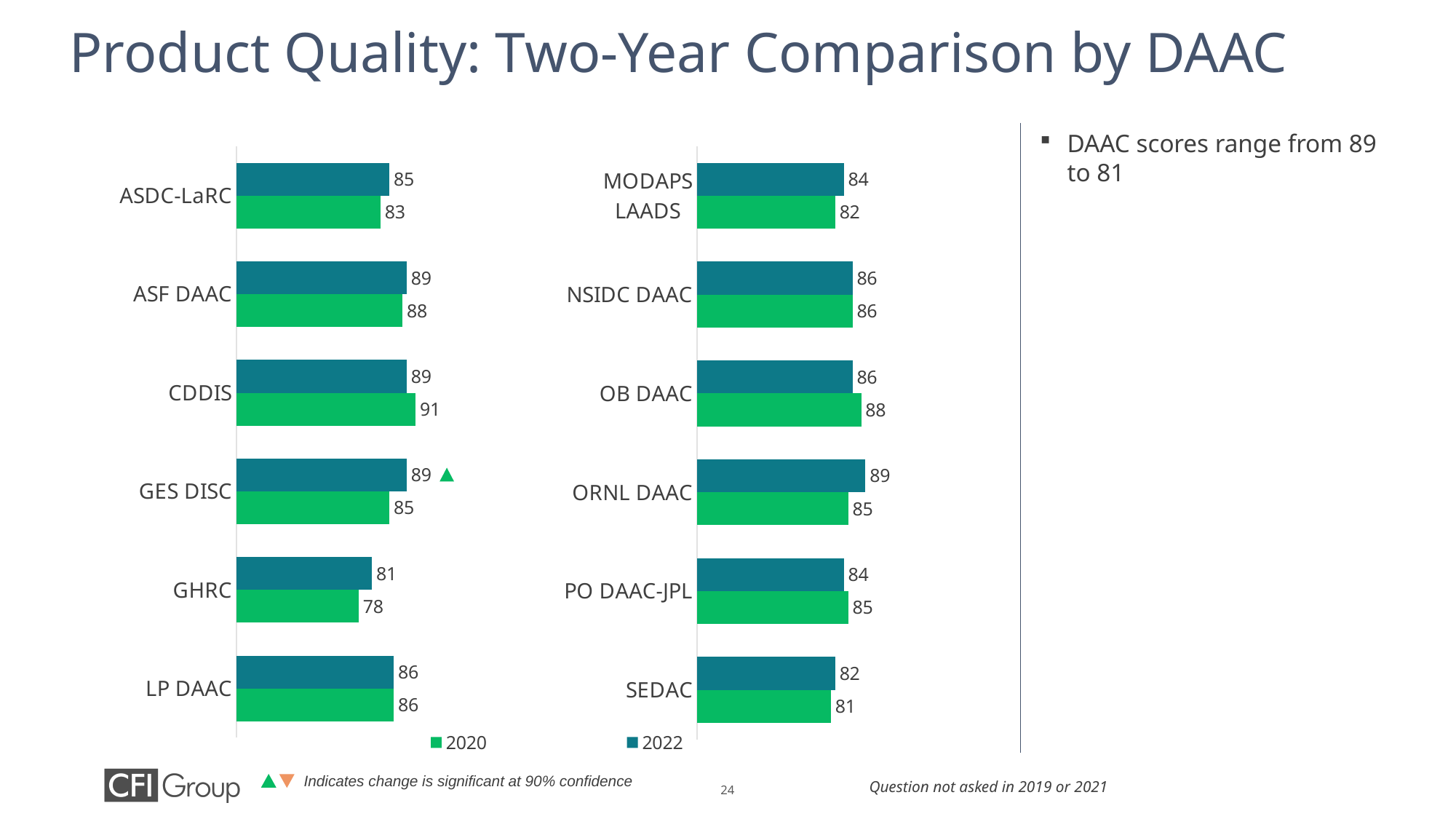
How many DAACs are shown in the left chart? 6 In the left chart, what is the difference between the 2022 and 2020 scores for GES DISC? 4 In the right chart, is the 2020 score for PO DAAC-JPL higher or lower than its 2022 score? higher In the right chart, what is the 2020 Product Quality score for OB DAAC? 88 How many series does the legend list for the charts? 2 In the left chart, which DAAC has the lowest 2020 score? GHRC What type of chart is used on this slide? bar chart Which colour represents the 2020 series in the legend? green In the left chart, what is the 2020 score for GHRC? 78 In the right chart, which DAAC has the highest 2022 score? ORNL DAAC In the left chart, what is the 2022 Product Quality score for GES DISC? 89 In the right chart, what is the difference between the 2022 and 2020 scores for ORNL DAAC? 4